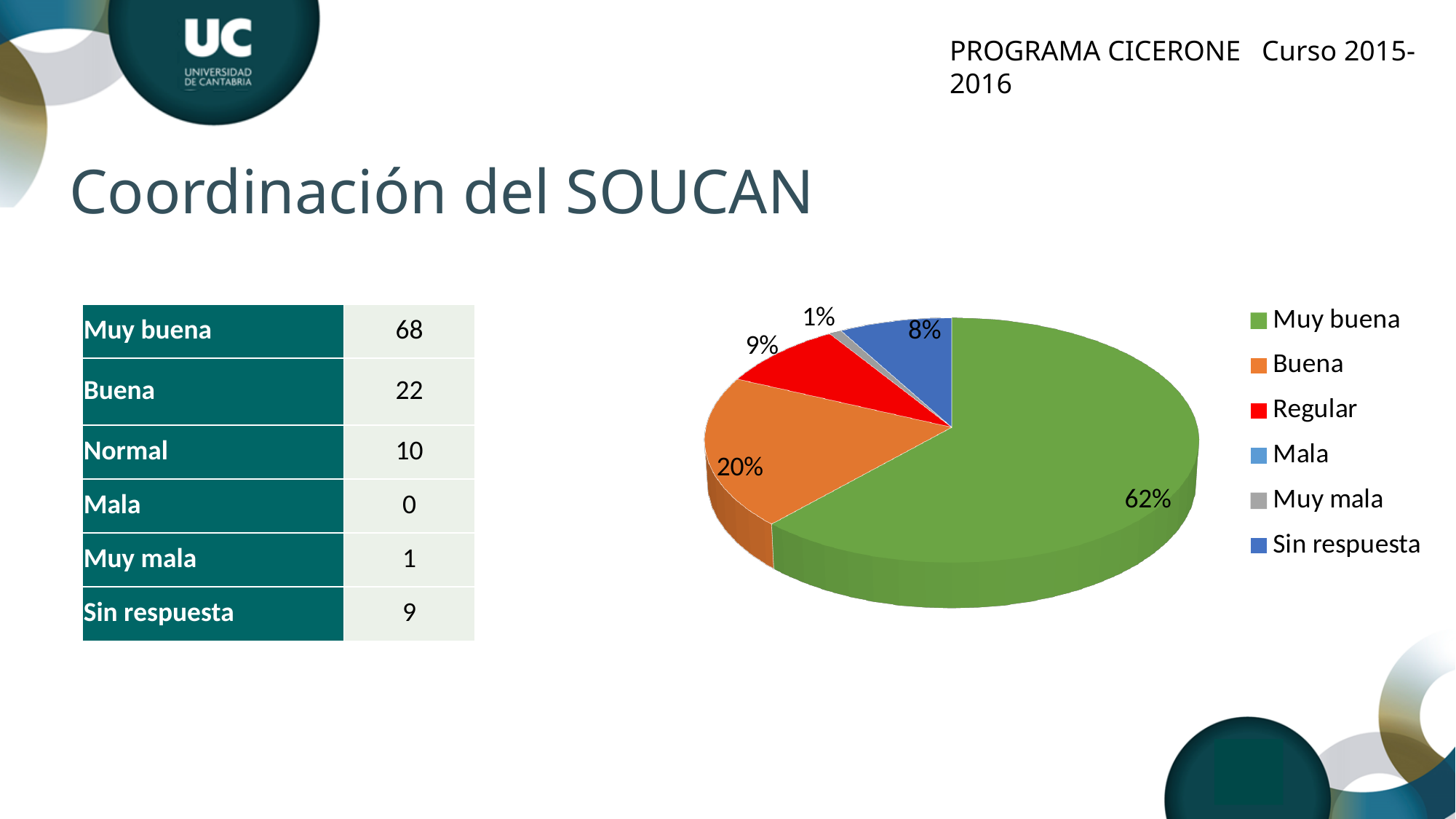
Which category has the largest slice in the pie chart? Muy buena What percentage does the pie chart show for Sin respuesta? 8% What type of chart is shown on the slide? Pie chart What percentage does the pie chart show for Muy buena? 62% Which of the labelled slices in the pie chart is the smallest? Muy mala What percentage does the pie chart show for Muy mala? 1% What colour is the Muy buena slice in the pie chart? Green What percentage does the pie chart show for Regular? 9% What is the difference in percentage points between the Muy buena and Buena slices? 42 What percentage does the pie chart show for Buena? 20% Which slice is larger in the pie chart, Regular or Sin respuesta? Regular How many entries does the legend of the pie chart list? 6